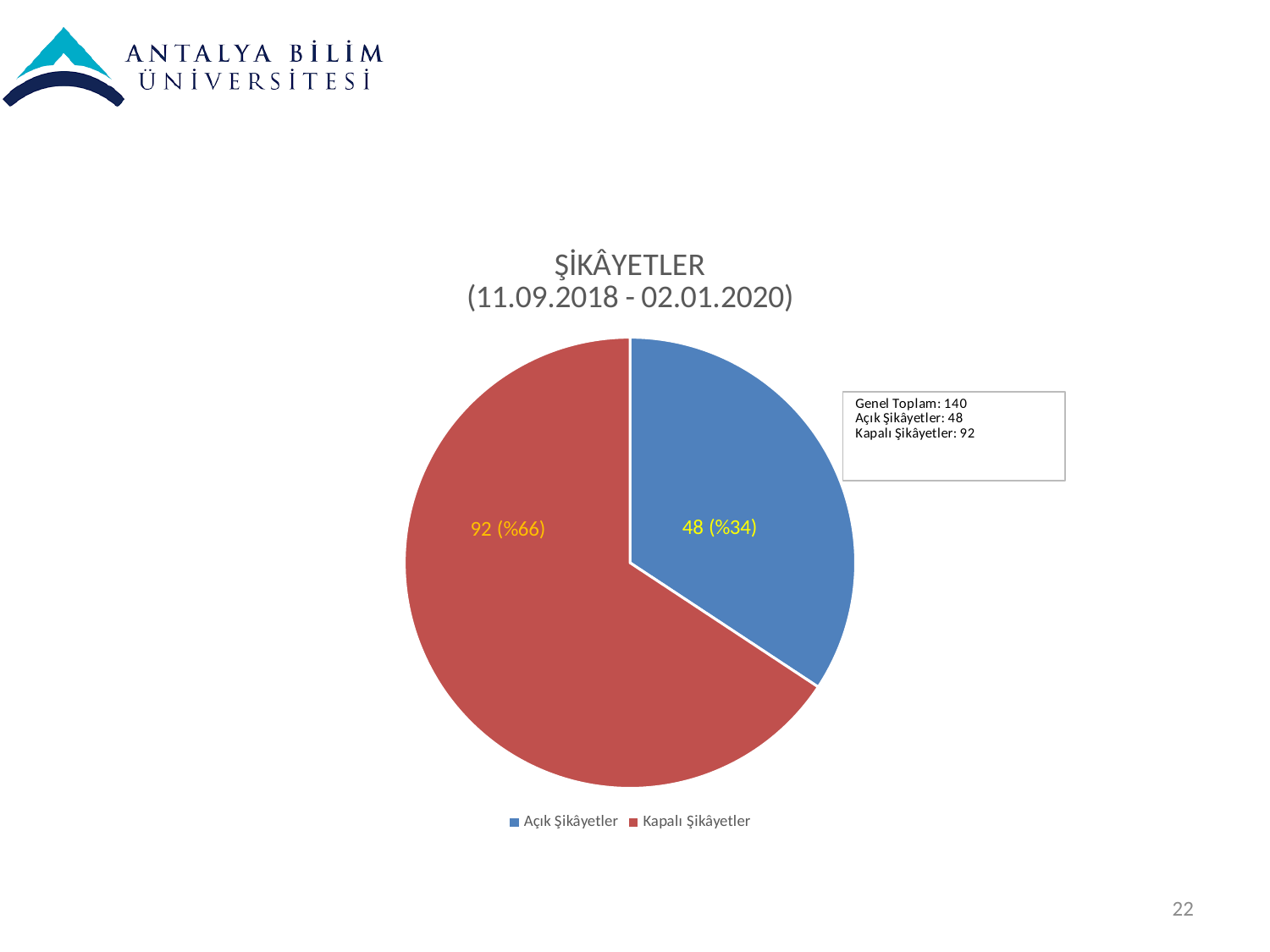
What is the value for Kapalı Şikâyetler? 92 How many slices does the pie chart have? 2 Which category has the smallest slice? Açık Şikâyetler What kind of chart is shown on the slide? pie chart What date range is given in the chart title? 11.09.2018 - 02.01.2020 Which is larger, Açık Şikâyetler or Kapalı Şikâyetler? Kapalı Şikâyetler What share of the pie does Açık Şikâyetler represent? %34 What is the value for Açık Şikâyetler? 48 What is the difference between the values for Kapalı Şikâyetler and Açık Şikâyetler? 44 What is the total of all slices in the pie chart? 140 Which category has the largest slice? Kapalı Şikâyetler What share of the pie does Kapalı Şikâyetler represent? %66